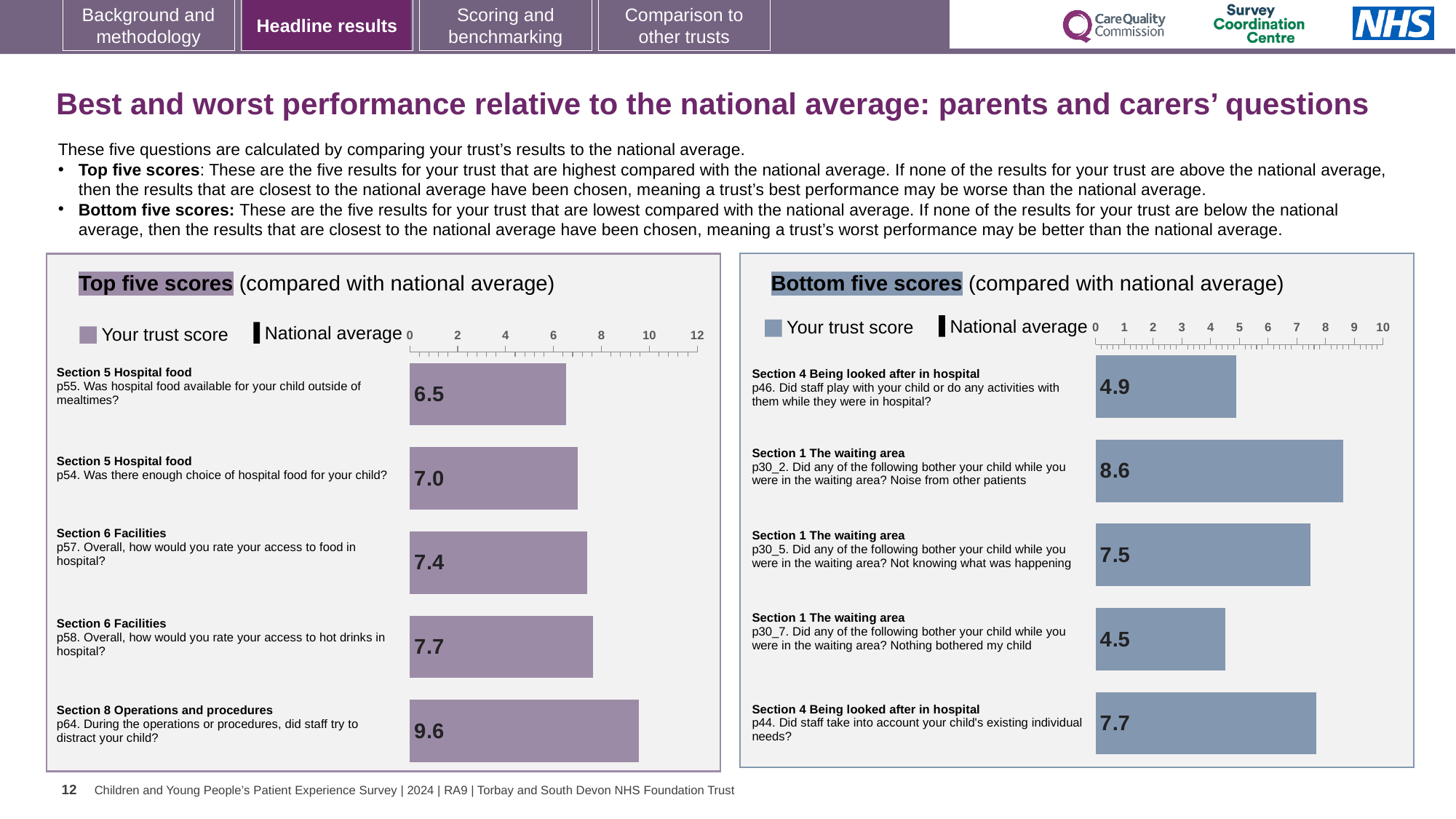
In the Top five scores chart, what is the trust score for p55 (Was hospital food available for your child outside of mealtimes?)? 6.5 How many questions are plotted in the Top five scores chart? 5 In the Bottom five scores chart, what is the trust score for p30_2 (Noise from other patients)? 8.6 In the Bottom five scores chart, which has the larger trust score: p46 (Did staff play with your child) or p30_5 (Not knowing what was happening)? p30_5. Not knowing what was happening In the Top five scores chart, which question has the highest trust score? p64. During the operations or procedures, did staff try to distract your child? In the Top five scores chart, what is the trust score for p64 (During the operations or procedures, did staff try to distract your child?)? 9.6 In the Bottom five scores chart, what is the difference between the trust scores for p30_2 and p30_7? 4.1 In the Top five scores chart, what is the difference between the trust scores for p64 and p55? 3.1 In the Bottom five scores chart, what is the trust score for p44 (Did staff take into account your child's existing individual needs?)? 7.7 How many entries does the legend of the Top five scores chart list? 2 What type of chart is the Bottom five scores chart? Bar chart In the Bottom five scores chart, which question has the lowest trust score? p30_7. Nothing bothered my child